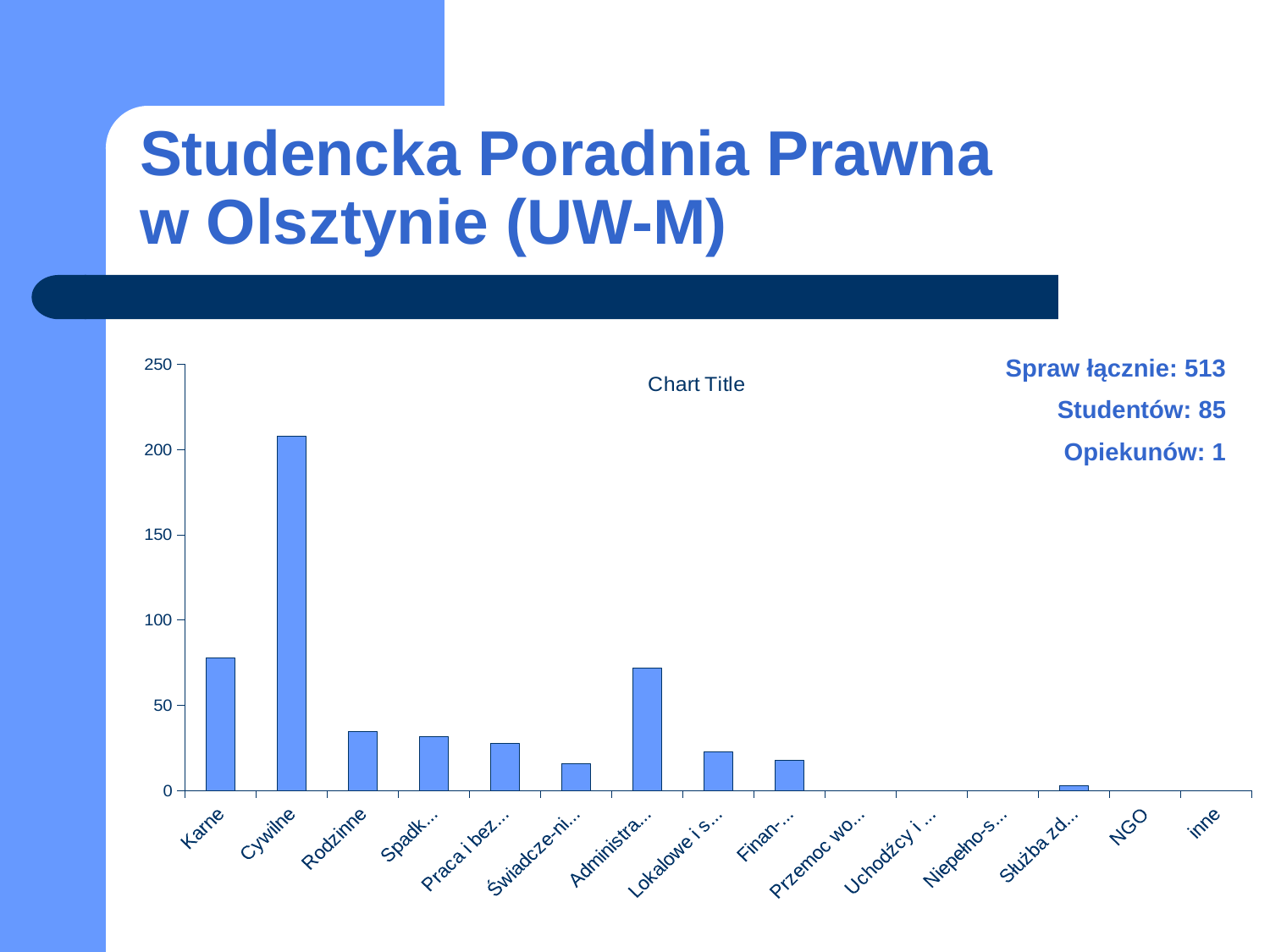
Is the value for Karne greater or less than 100? less Is the value for Cywilne greater or less than 200? greater Which has the larger value, Rodzinne or the category labelled 'Świadcze-ni...'? Rodzinne What kind of chart is shown on the slide? bar chart Is the value for Rodzinne greater or less than 50? less Which has the larger value, Karne or Cywilne? Cywilne What is the highest value shown on the vertical axis of the chart? 250 Which category has the highest bar in the chart? Cywilne How many categories are shown on the x axis of the chart? 15 What is the title shown on the chart? Chart Title